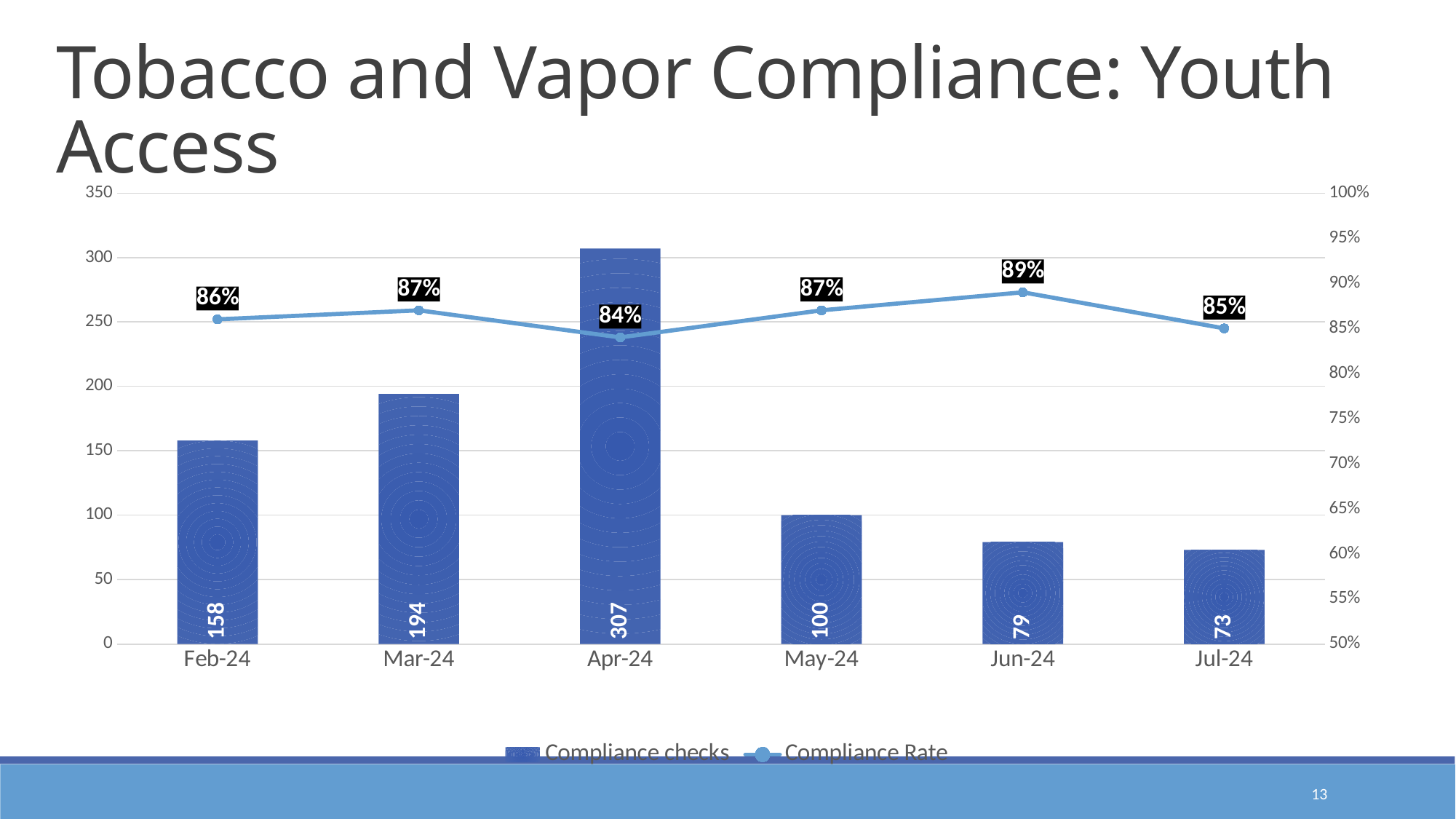
Which month had the lowest number of compliance checks? Jul-24 Which month had more compliance checks, May-24 or Jun-24? May-24 What kind of chart is used to show the compliance checks? Bar chart Is the number of compliance checks in Apr-24 greater or less than 300? greater What was the compliance rate in Jun-24? 89% How many series does the legend list? 2 How many months are shown on the x axis? 6 Which month had the highest number of compliance checks? Apr-24 What is the difference in compliance checks between Mar-24 and Feb-24? 36 Do the compliance checks rise or fall from Apr-24 to Jul-24? Fall How many compliance checks were conducted in Apr-24? 307 Which month had the lowest compliance rate? Apr-24